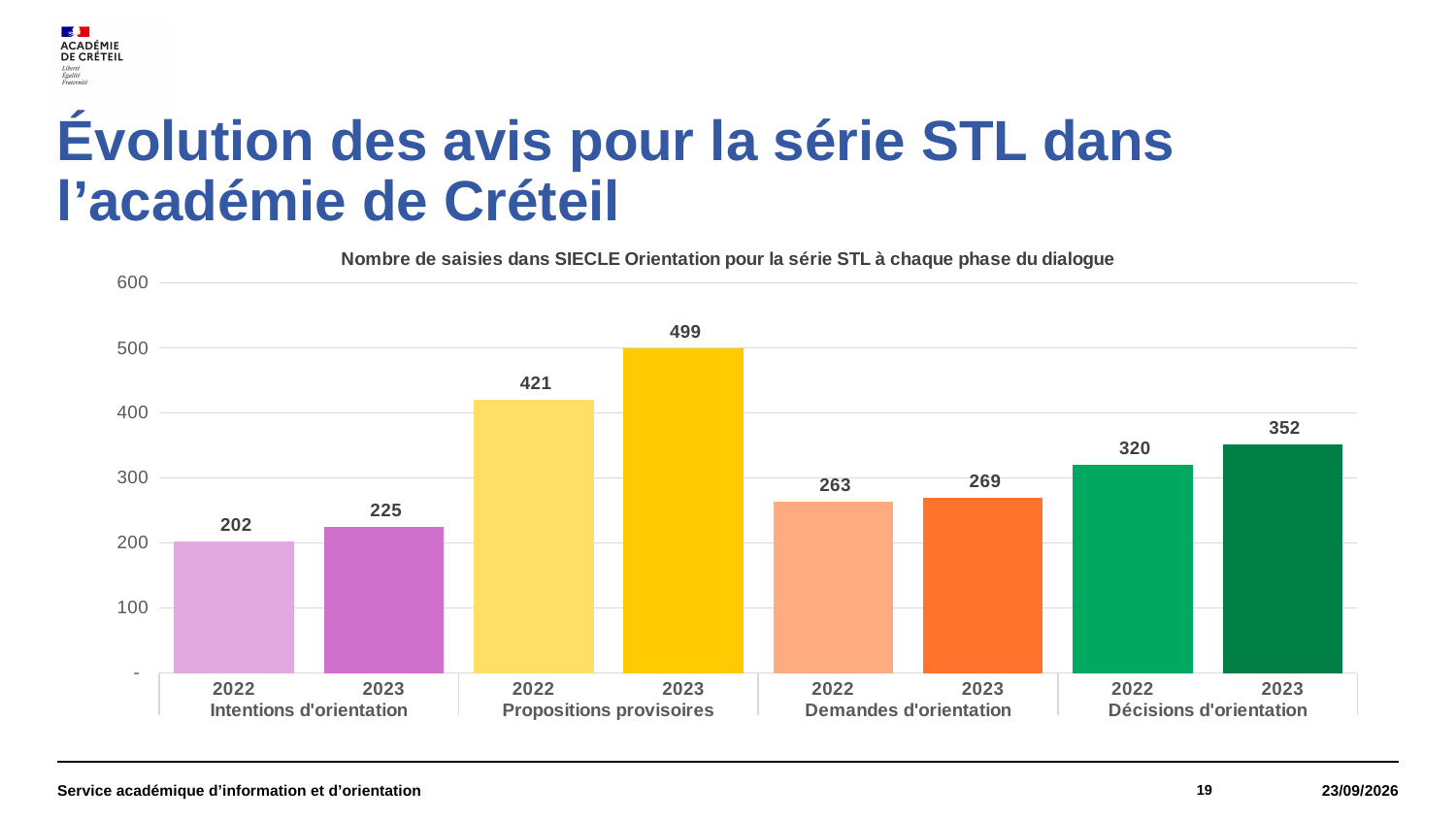
What is the value for 2023 under Propositions provisoires? 499 What is the value for 2023 under Décisions d'orientation? 352 What is the value for 2022 under Intentions d'orientation? 202 Which is larger: the 2022 value for Demandes d'orientation or the 2022 value for Décisions d'orientation? 2022 Décisions d'orientation Which bar has the highest value? 2023 Propositions provisoires Which bar has the lowest value? 2022 Intentions d'orientation How many bars are plotted on the chart? 8 What is the difference between the 2023 and 2022 values for Propositions provisoires? 78 What is the title of the chart? Nombre de saisies dans SIECLE Orientation pour la série STL à chaque phase du dialogue What is the difference between the 2023 and 2022 values for Décisions d'orientation? 32 What kind of chart is shown? bar chart Is the value for 2023 Demandes d'orientation greater or less than 300? less